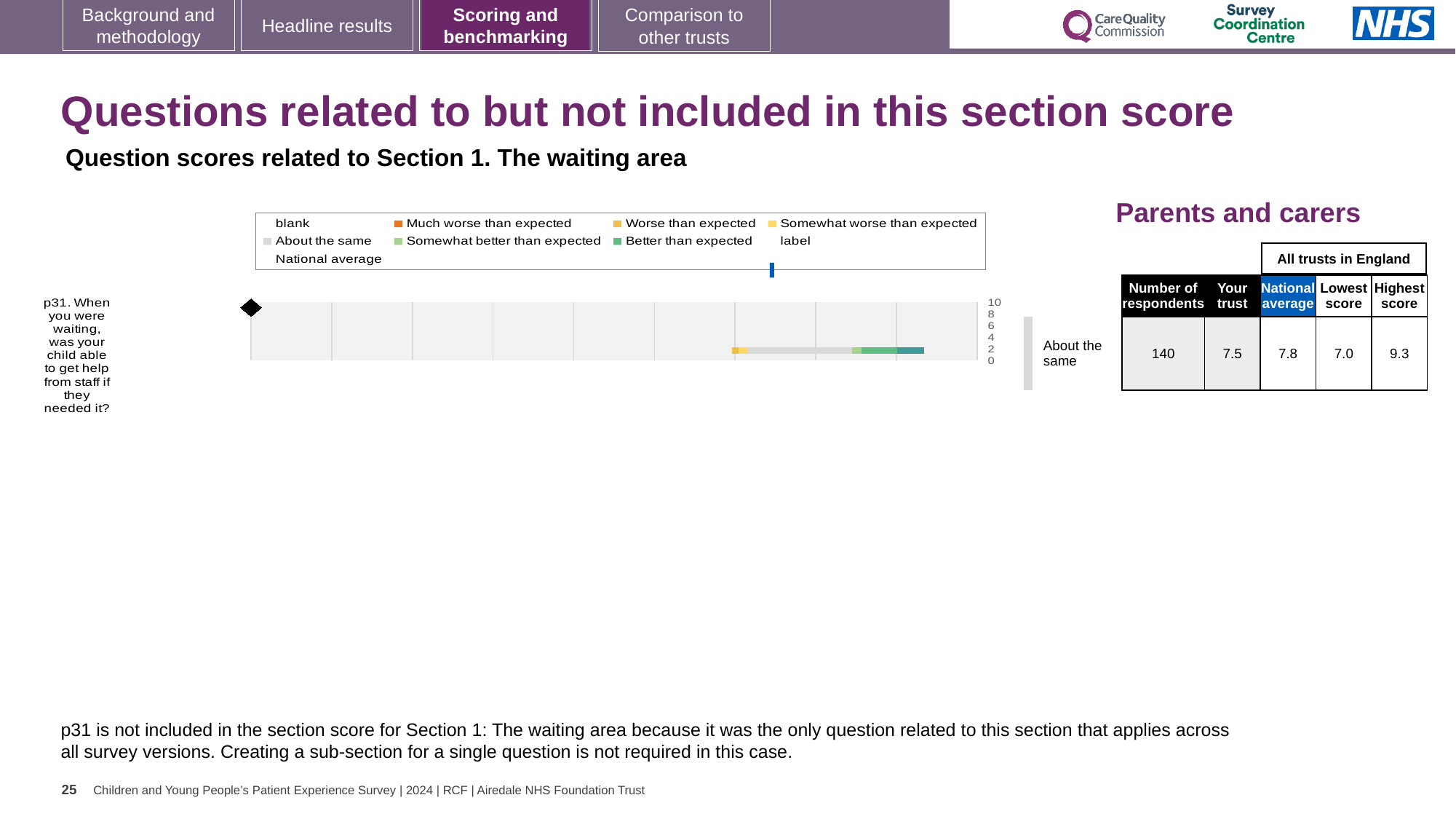
How many survey questions are plotted in the chart? 1 What is the 'Your trust' score for p31 in the Parents and carers table? 7.5 What is the difference between the national average and the 'Your trust' score for p31? 0.3 What kind of chart is used to show the p31 benchmark result? bar chart What is the national average score for p31? 7.8 What is the difference between the highest score and the lowest score for p31? 2.3 Which question number is plotted in the chart? p31 How many respondents answered p31? 140 What is the lowest score across all trusts in England for p31? 7.0 What benchmark category label is shown to the right of the p31 bar? About the same Which is larger for p31, the 'Your trust' score or the national average? National average What is the highest score across all trusts in England for p31? 9.3